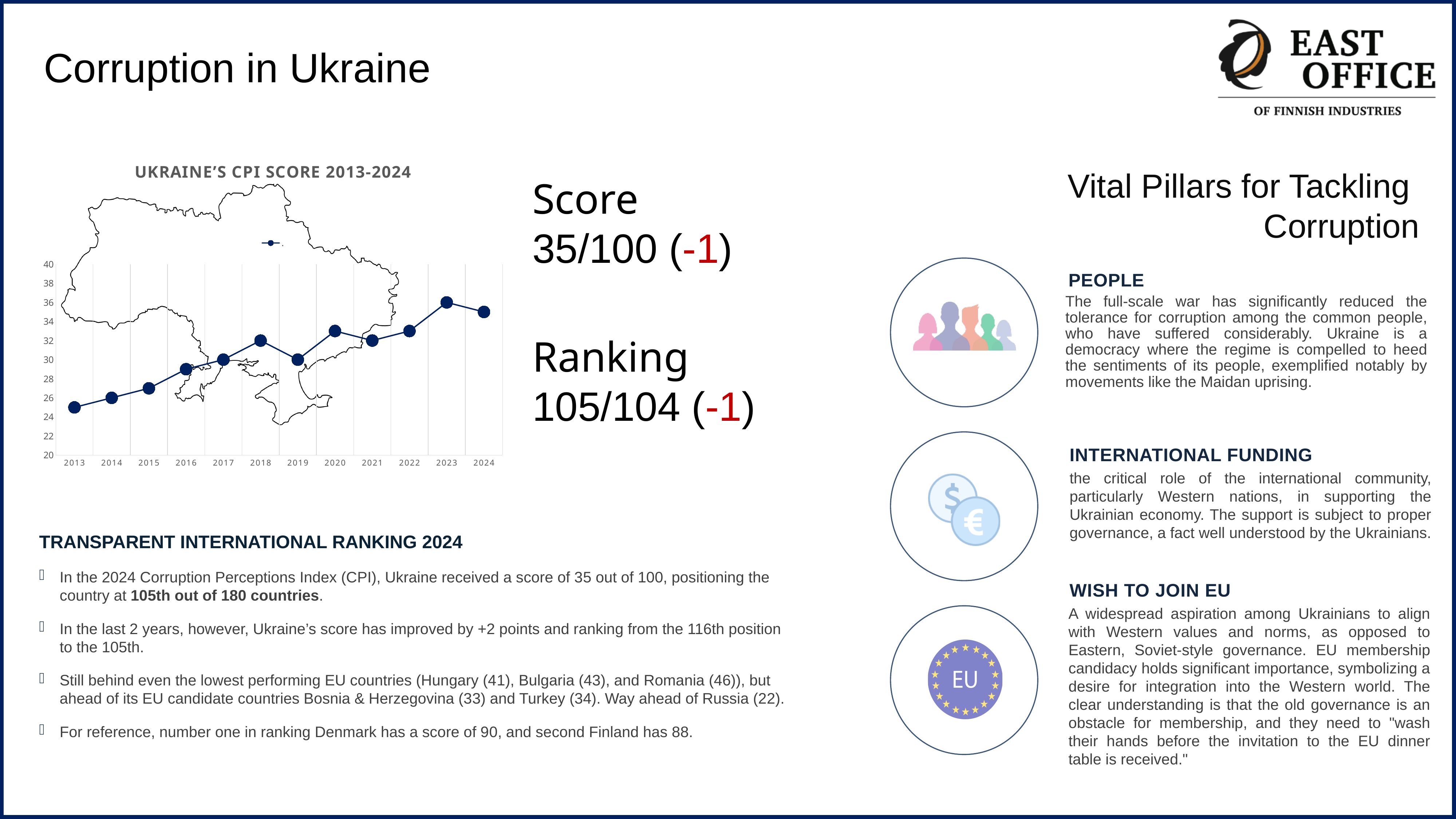
What is Ukraine's CPI score for 2023 on the chart? 36 How many years are plotted on the chart? 12 Which year has the highest CPI score on the chart? 2023 Is the CPI score for 2018 higher or lower than the score for 2019? higher What is Ukraine's CPI score for 2018 on the chart? 32 Does Ukraine's CPI score generally rise or fall from 2013 to 2024? rise What is the title of the chart? UKRAINE'S CPI SCORE 2013-2024 Is the CPI score for 2013 greater or less than 28? less What kind of chart is shown on the slide? line chart What is the difference between the CPI scores for 2023 and 2019? 6 Which year has the lowest CPI score on the chart? 2013 What is Ukraine's CPI score for 2019 on the chart? 30